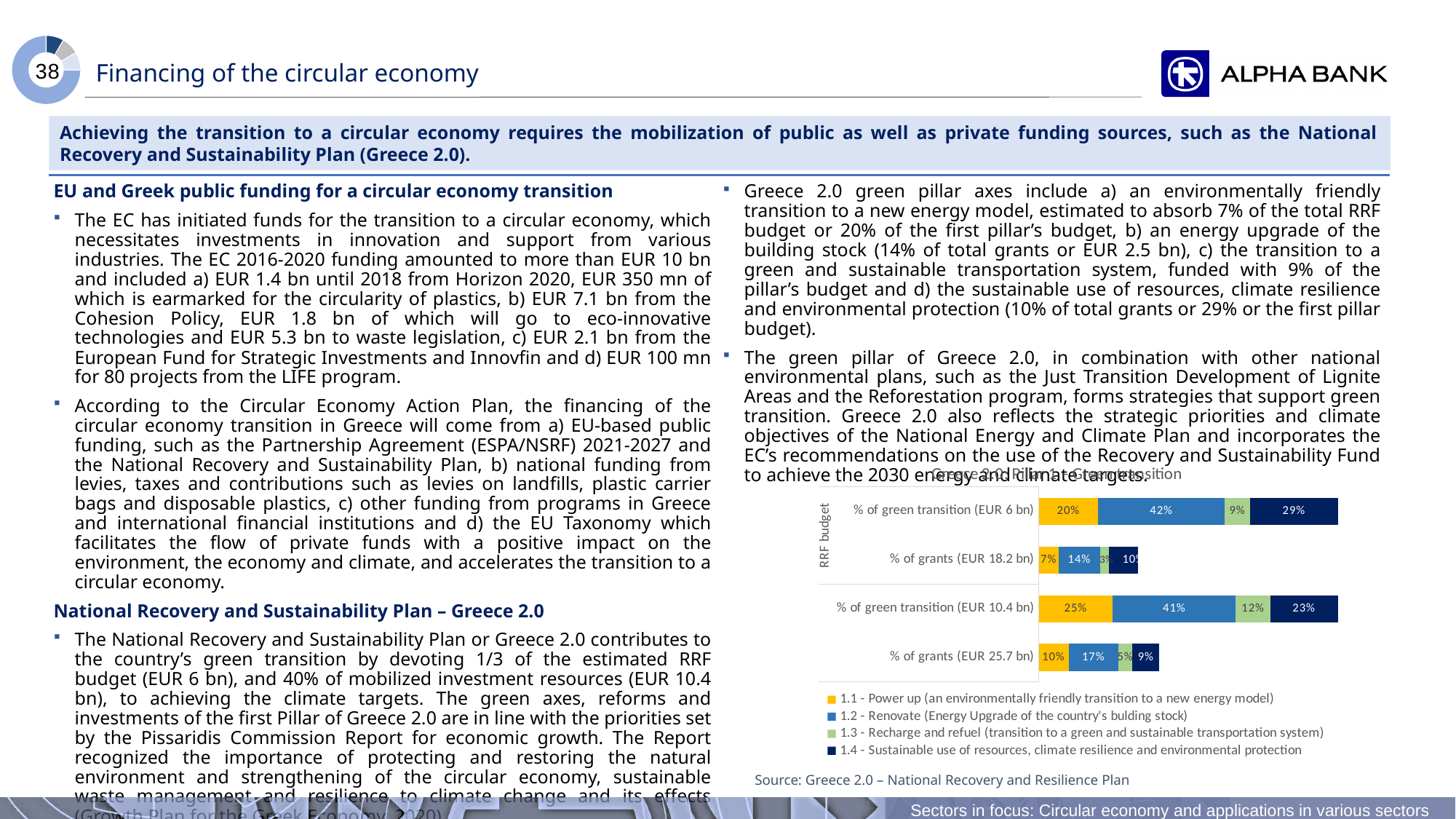
What is the value of 1.1 - Power up for the '% of green transition (EUR 10.4 bn)' bar? 25% Is the 1.4 - Sustainable use of resources share larger in the '% of green transition (EUR 6 bn)' bar or the '% of green transition (EUR 10.4 bn)' bar? % of green transition (EUR 6 bn) What is the value of 1.2 - Renovate for the '% of green transition (EUR 6 bn)' bar? 42% How many series does the chart's legend list? 4 In the '% of green transition (EUR 6 bn)' bar, how much larger is the 1.2 - Renovate share than the 1.1 - Power up share? 22 percentage points What is the total of the four segments in the '% of green transition (EUR 6 bn)' bar? 100% Which series has the largest segment in the '% of green transition (EUR 10.4 bn)' bar? 1.2 - Renovate What is the value of 1.2 - Renovate for the '% of grants (EUR 25.7 bn)' bar? 17% How many bars (categories) are plotted in the chart? 4 What is the value of 1.3 - Recharge and refuel for the '% of green transition (EUR 10.4 bn)' bar? 12% What kind of chart is shown on the slide? Stacked bar chart What is the value of 1.4 - Sustainable use of resources for the '% of green transition (EUR 6 bn)' bar? 29%